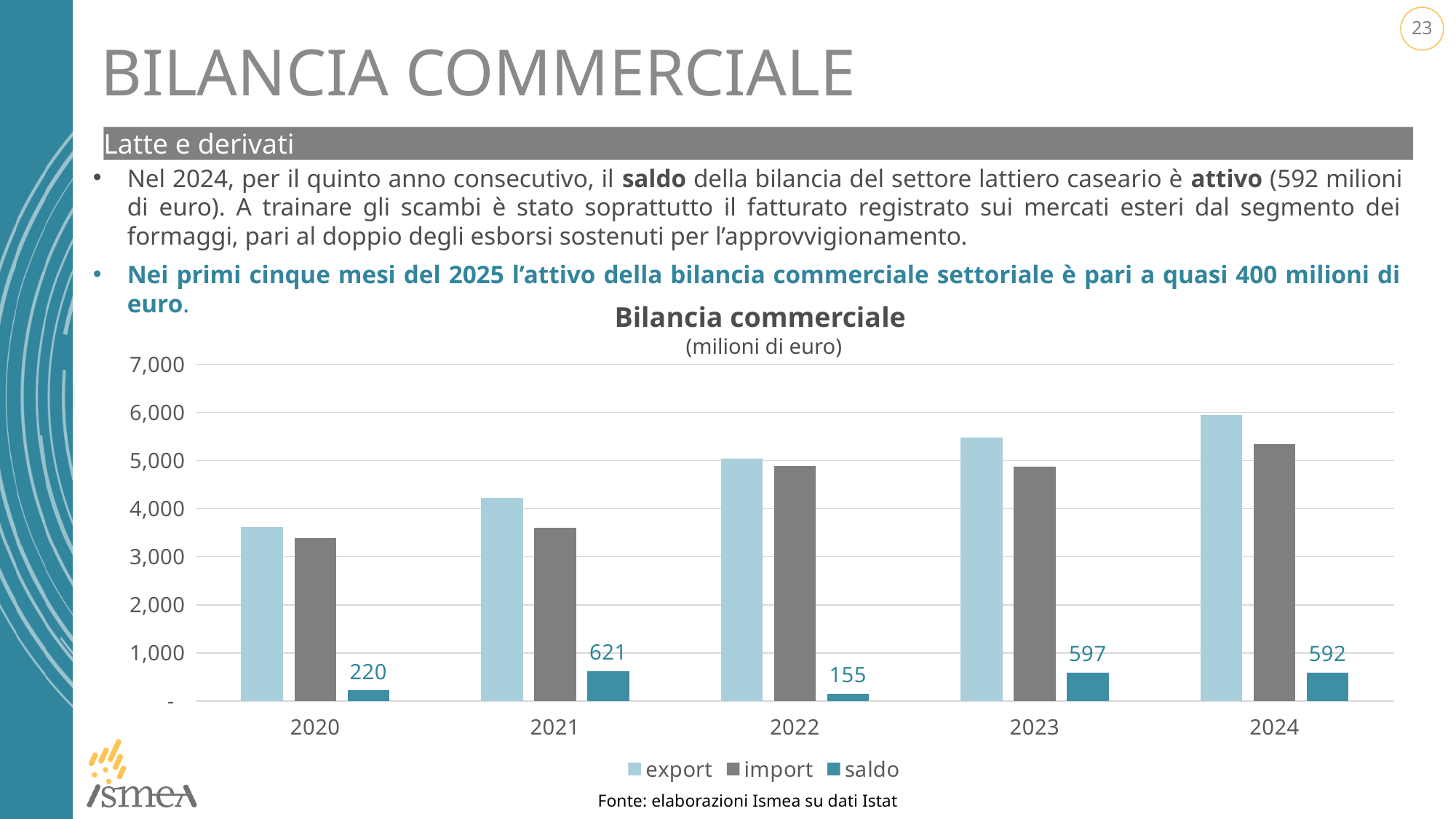
Does the export value rise or fall from 2020 to 2024? rise What is the value of saldo for 2022? 155 Is the export value for 2024 greater or less than 5,000? greater What is the value of saldo for 2021? 621 In which year is the saldo highest? 2021 What kind of chart is shown on the slide? bar chart What is the difference between the saldo in 2021 and the saldo in 2020? 401 In which year is the saldo lowest? 2022 How many series does the legend list? 3 Which year has the larger saldo, 2023 or 2024? 2023 Is the import value for 2020 greater or less than 4,000? less How many years are shown on the x axis of the chart? 5